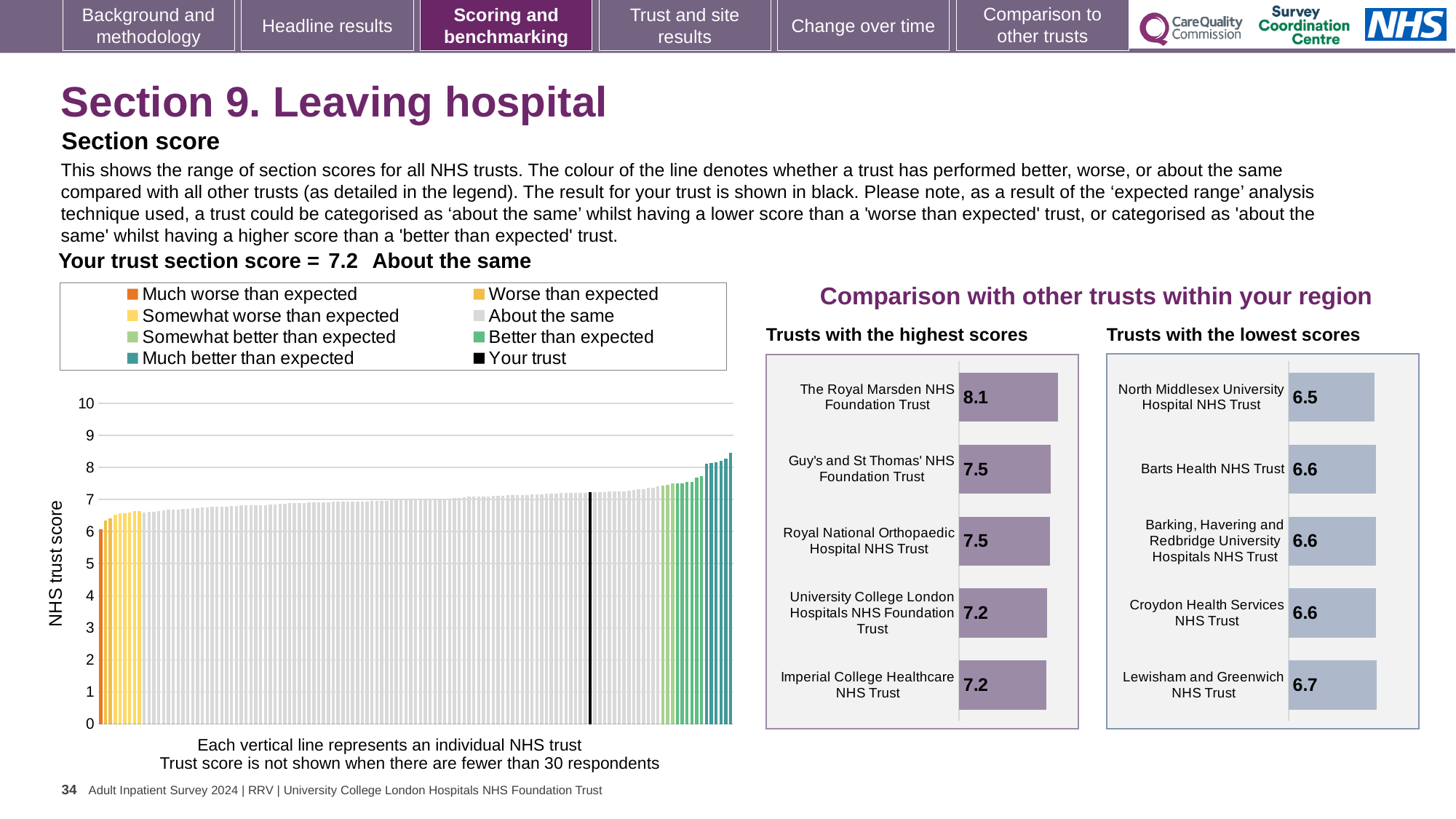
In the 'Trusts with the lowest scores' chart, which has the larger score: Lewisham and Greenwich NHS Trust or Barts Health NHS Trust? Lewisham and Greenwich NHS Trust In the main section score chart, do the trust scores rise or fall from left to right along the x axis? Rise In the main section score chart, what is the section score for your trust? 7.2 How many entries does the legend of the main section score chart list? 8 In the 'Trusts with the lowest scores' chart, which trust has the lowest score? North Middlesex University Hospital NHS Trust How many trusts are shown in the 'Trusts with the highest scores' chart? 5 In the 'Trusts with the highest scores' chart, what is the difference between the scores of The Royal Marsden NHS Foundation Trust and Imperial College Healthcare NHS Trust? 0.9 What is the y-axis label of the main section score chart? NHS trust score In the 'Trusts with the highest scores' chart, what is the score for The Royal Marsden NHS Foundation Trust? 8.1 What kind of chart is the main section score chart on the left of the slide? Bar chart In the 'Trusts with the lowest scores' chart, what is the score for North Middlesex University Hospital NHS Trust? 6.5 In the 'Trusts with the highest scores' chart, which trust has the highest score? The Royal Marsden NHS Foundation Trust